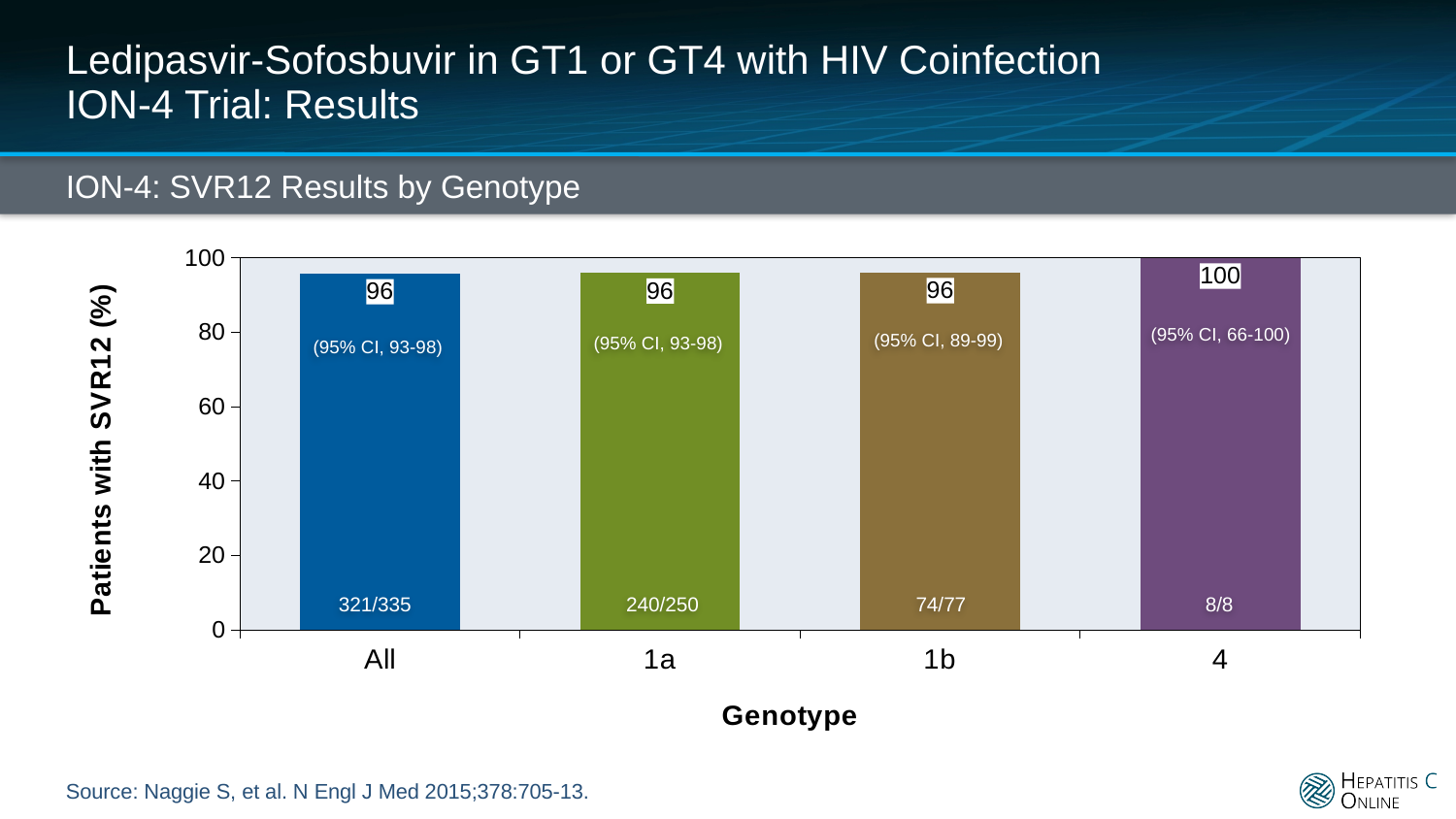
What is the difference between the SVR12 rate for genotype 4 and genotype 1a? 4 What is the SVR12 rate for genotype 4? 100 What is the title of the chart? ION-4: SVR12 Results by Genotype What is the SVR12 rate for genotype 1b? 96 What is the label of the y axis? Patients with SVR12 (%) Is the SVR12 rate for genotype 1b greater or less than 80? greater What is the 95% CI shown for genotype 4? 66-100 What kind of chart is shown on the slide? Bar chart Which genotype category has the highest SVR12 rate? 4 What fraction of patients is shown at the bottom of the 'All' bar? 321/335 How many genotype categories are shown on the x axis? 4 What is the SVR12 rate for the 'All' genotype group? 96